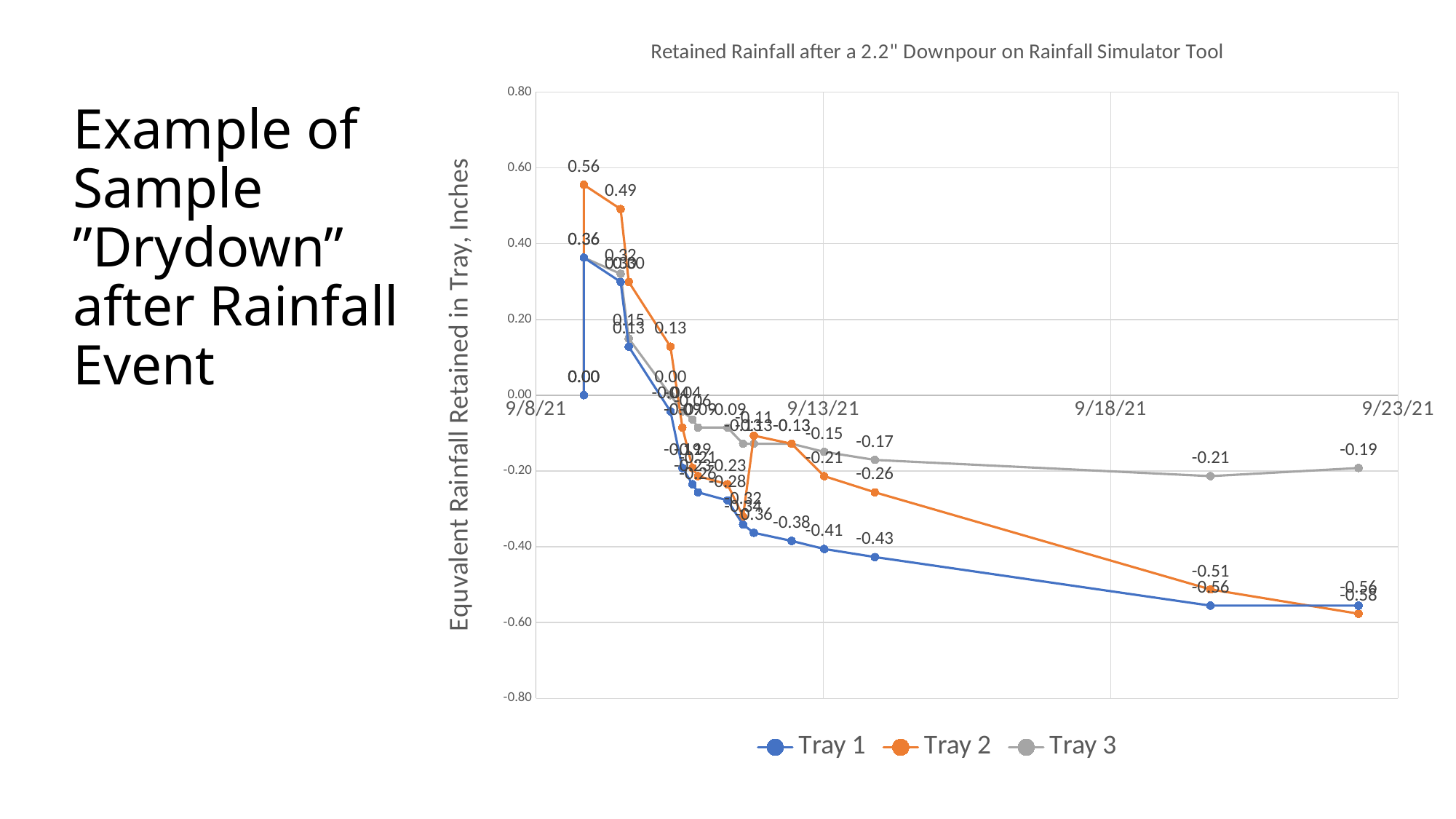
What is the highest value reached by Tray 1? 0.36 What kind of chart is shown on the slide? line chart How many series does the legend list? 3 Which tray reaches the highest value on the chart? Tray 2 Is the final value for Tray 1 greater or less than -0.40? less What is the value for Tray 2 at the point just before 9/23/21, around 9/21/21? -0.51 What is the title of the chart? Retained Rainfall after a 2.2" Downpour on Rainfall Simulator Tool What is the final plotted value for Tray 3, near 9/23/21? -0.19 What are the series names listed in the legend? Tray 1, Tray 2, Tray 3 What is the highest value reached by Tray 2? 0.56 At the last date on the chart, which series has the higher value, Tray 3 or Tray 2? Tray 3 What is the difference between the peak value of Tray 2 (0.56) and the peak value of Tray 1 (0.36)? 0.20